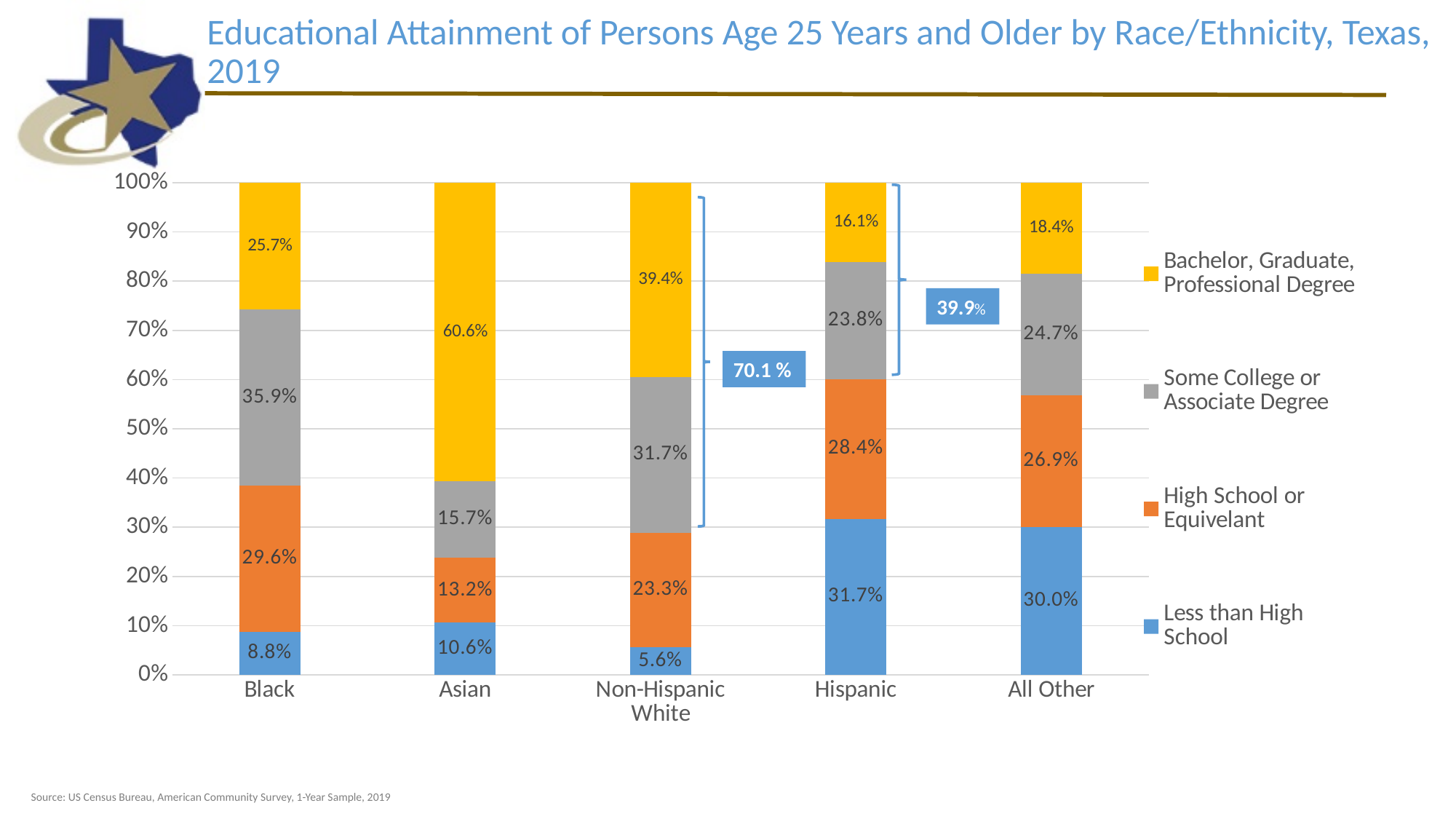
What percentage of Asian persons age 25 and older have a Bachelor, Graduate, or Professional Degree? 60.6% What is the Less than High School value for the Hispanic category? 31.7% Which race/ethnicity category has the highest share with a Bachelor, Graduate, or Professional Degree? Asian How many race/ethnicity categories are shown on the x axis? 5 What is the High School or Equivelant value for the Black category? 29.6% What is the Some College or Associate Degree value for All Other? 24.7% What is the difference in percentage points between the Less than High School share for Hispanic and for Black? 22.9 percentage points Which has a larger Some College or Associate Degree share, Black or Asian? Black What kind of chart is shown on the slide? Stacked bar chart How many series does the legend list? 4 Which colour represents the Less than High School series? Blue Which race/ethnicity category has the lowest Less than High School share? Non-Hispanic White